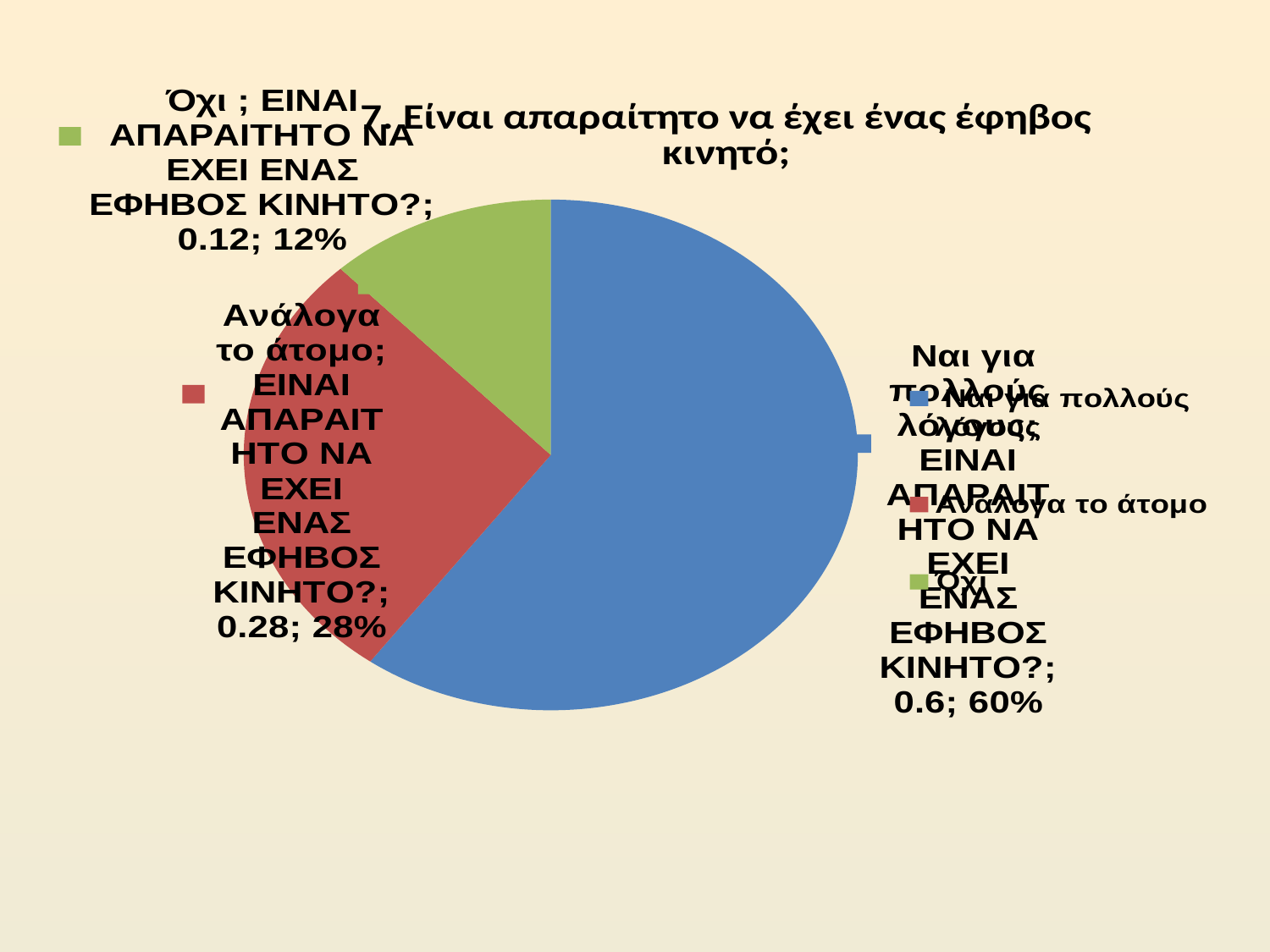
How many entries does the legend list? 3 What is the title of the pie chart? 7. Είναι απαραίτητο να έχει ένας έφηβος κινητό; Which category has the largest slice of the pie? Ναι για πολλούς λόγους What percentage of the pie is the slice for "Ναι για πολλούς λόγους"? 60% What is the difference in percentage points between the "Ναι για πολλούς λόγους" slice and the "Ανάλογα το άτομο" slice? 32 percentage points Which slice is larger, "Ανάλογα το άτομο" or "Όχι"? Ανάλογα το άτομο What type of chart is shown on the slide? pie chart What percentage of the pie is the slice for "Όχι"? 12% How many slices does the pie chart have? 3 What percentage of the pie is the slice for "Ανάλογα το άτομο"? 28% Which category has the smallest slice of the pie? Όχι What colour is the slice for "Όχι"? green